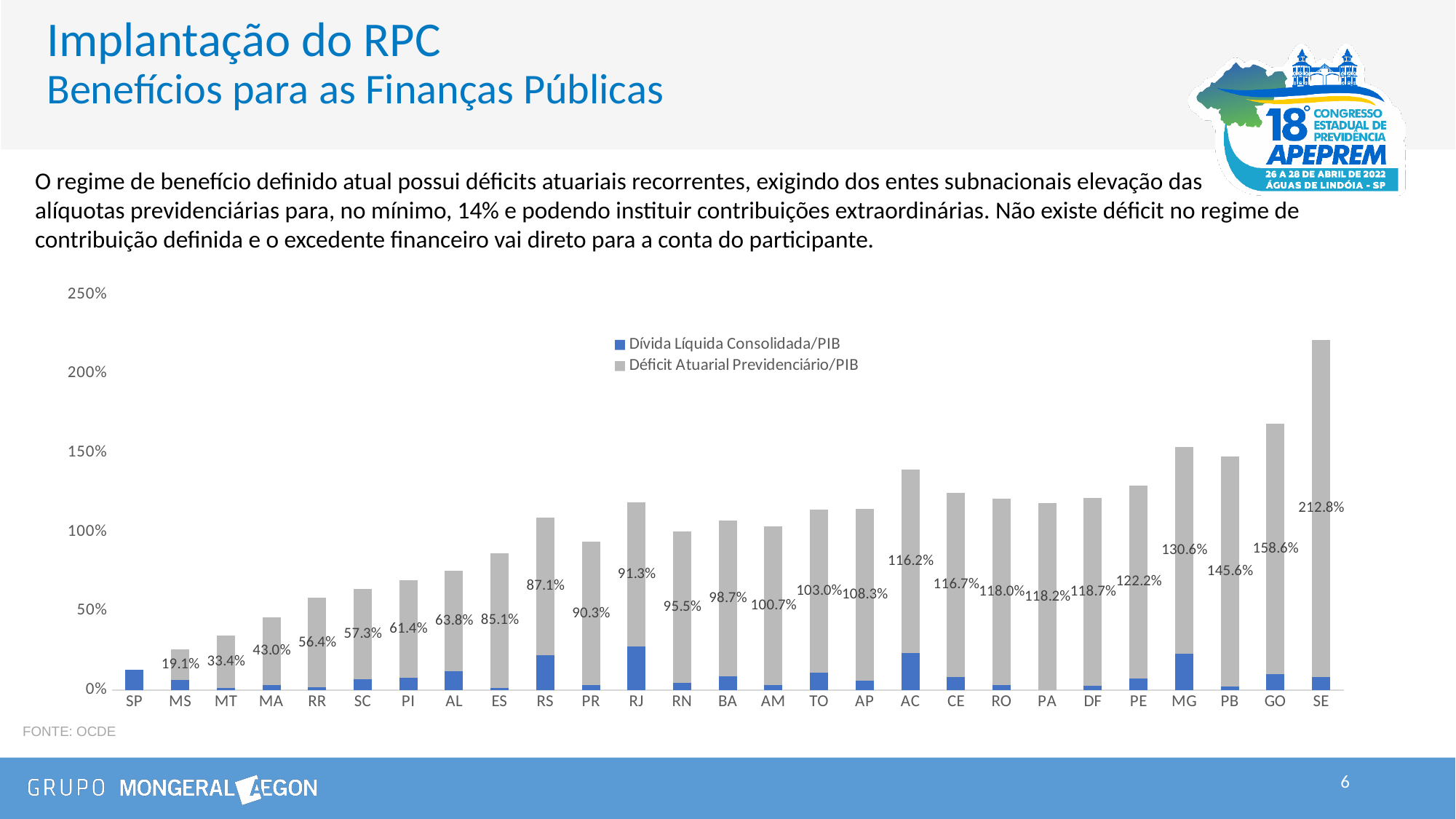
What is the Déficit Atuarial Previdenciário/PIB value shown for MS? 19.1% Which state has the highest Déficit Atuarial Previdenciário/PIB value? SE Do the Déficit Atuarial Previdenciário/PIB values generally rise or fall from left to right along the x axis? Rise What is the Déficit Atuarial Previdenciário/PIB value shown for SE? 212.8% Is the Dívida Líquida Consolidada/PIB value for RJ greater or less than 50%? less What kind of chart is shown on the slide? Stacked bar chart Is the total stacked bar for SE greater or less than 200%? greater What is the Déficit Atuarial Previdenciário/PIB value shown for MG? 130.6% How many states are shown on the x axis of the chart? 27 Which has a larger Déficit Atuarial Previdenciário/PIB value, PB or MG? PB What is the difference between the Déficit Atuarial Previdenciário/PIB values for SE and GO? 54.2 percentage points How many series does the chart legend list? 2